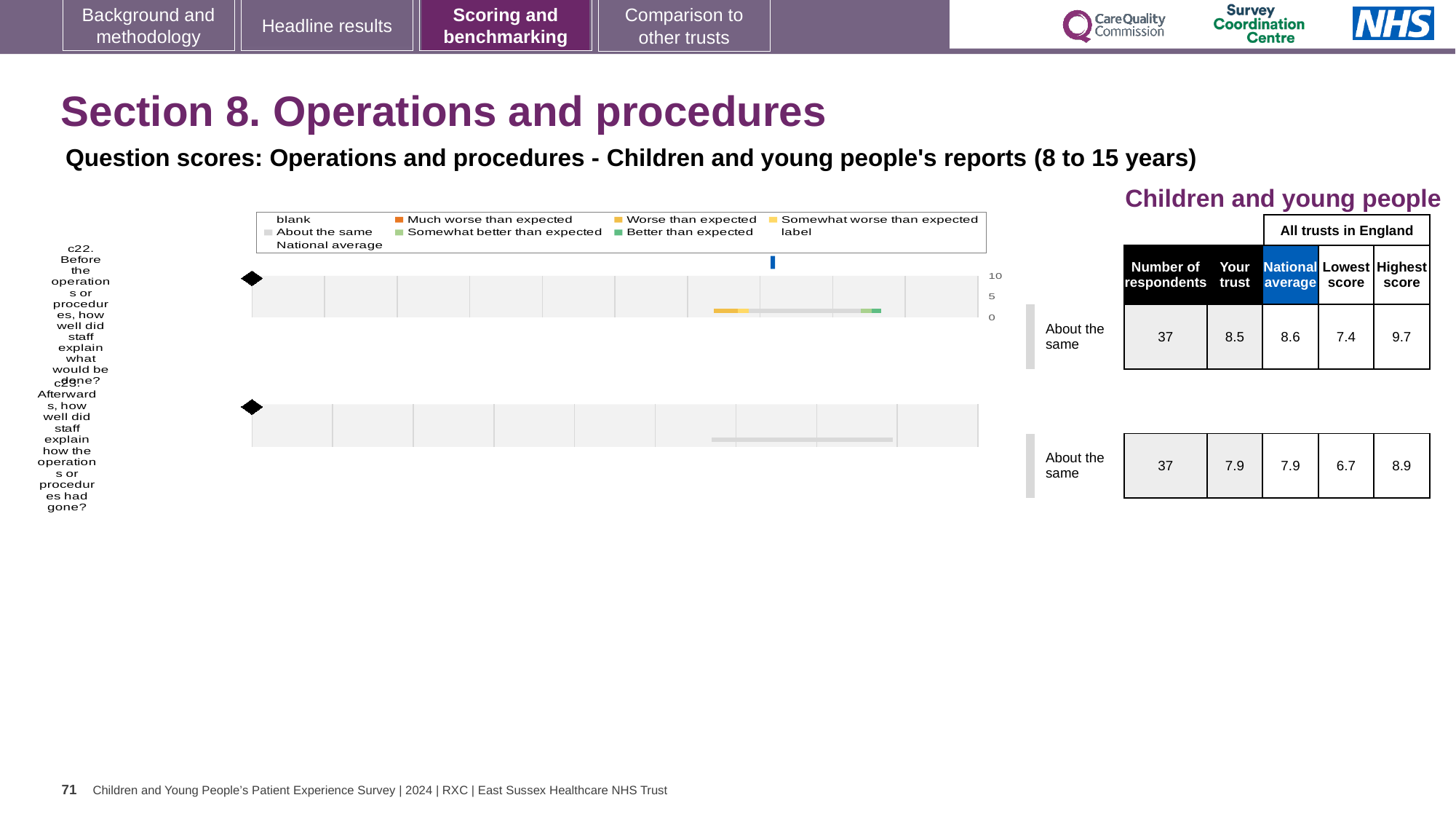
What benchmarking category is shown for question c22 next to its chart? About the same What is the highest score across all trusts in England for question c23, as shown in the table? 8.9 How many respondents answered question c22, according to the table next to the chart? 37 How many questions (c22 and c23) are charted on this slide? 2 What kind of chart is used to show the question scores on this slide? Bar chart For question c22, which is larger: the 'Your trust' score or the national average? National average In the chart legend, what colour represents 'Better than expected'? Green In the table beside the charts, what is the national average score for question c23 (Afterwards, how well did staff explain how the operations or procedures had gone?)? 7.9 In the table beside the charts, what is the 'Your trust' score for question c22 (Before the operations or procedures, how well did staff explain what would be done?)? 8.5 Which question has the higher 'Your trust' score in the table: c22 or c23? c22 For question c23, what is the difference between the highest score (8.9) and the lowest score (6.7) shown in the table? 2.2 For question c22, what is the difference between the highest score (9.7) and the lowest score (7.4) shown in the table? 2.3